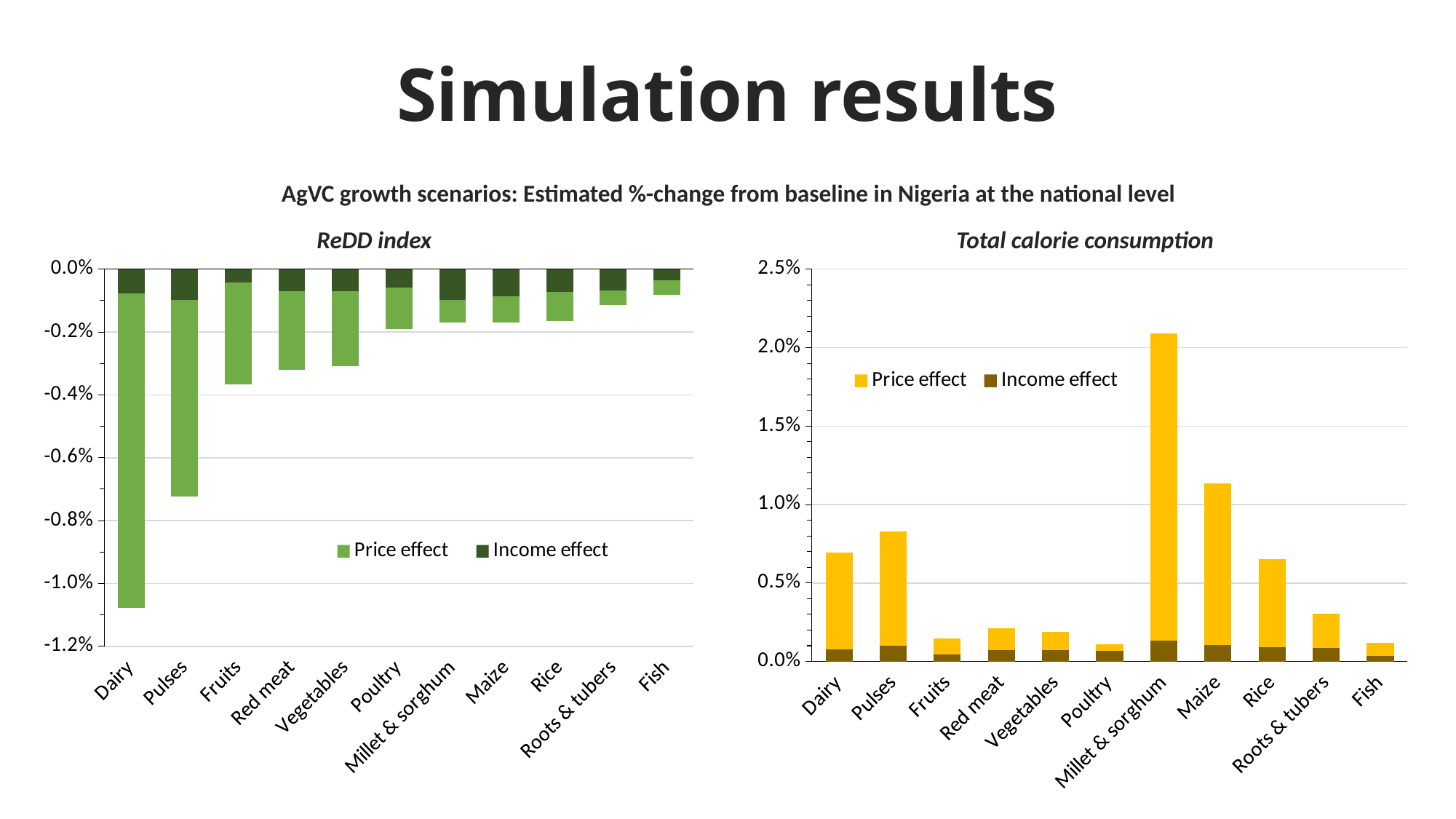
How many food categories are shown on the x axis of the Total calorie consumption chart? 11 In the Total calorie consumption chart, which category has the highest total bar? Millet & sorghum In the ReDD index chart, which category has the longest (most negative) bar? Dairy What is the shared title above the two charts? AgVC growth scenarios: Estimated %-change from baseline in Nigeria at the national level In the Total calorie consumption chart, which has the larger total bar, Maize or Rice? Maize In the Total calorie consumption chart, is the total value for Millet & sorghum greater or less than 2.0%? greater What are the two legend entries in the Total calorie consumption chart? Price effect and Income effect In the ReDD index chart, is the total value for Dairy greater or less than -1.0%? less How many series does the legend of the ReDD index chart list? 2 In the ReDD index chart, is the total value for Pulses greater or less than -0.6%? less In the Total calorie consumption chart, which has the larger total bar, Dairy or Pulses? Pulses What kind of chart is the ReDD index chart? Stacked bar chart